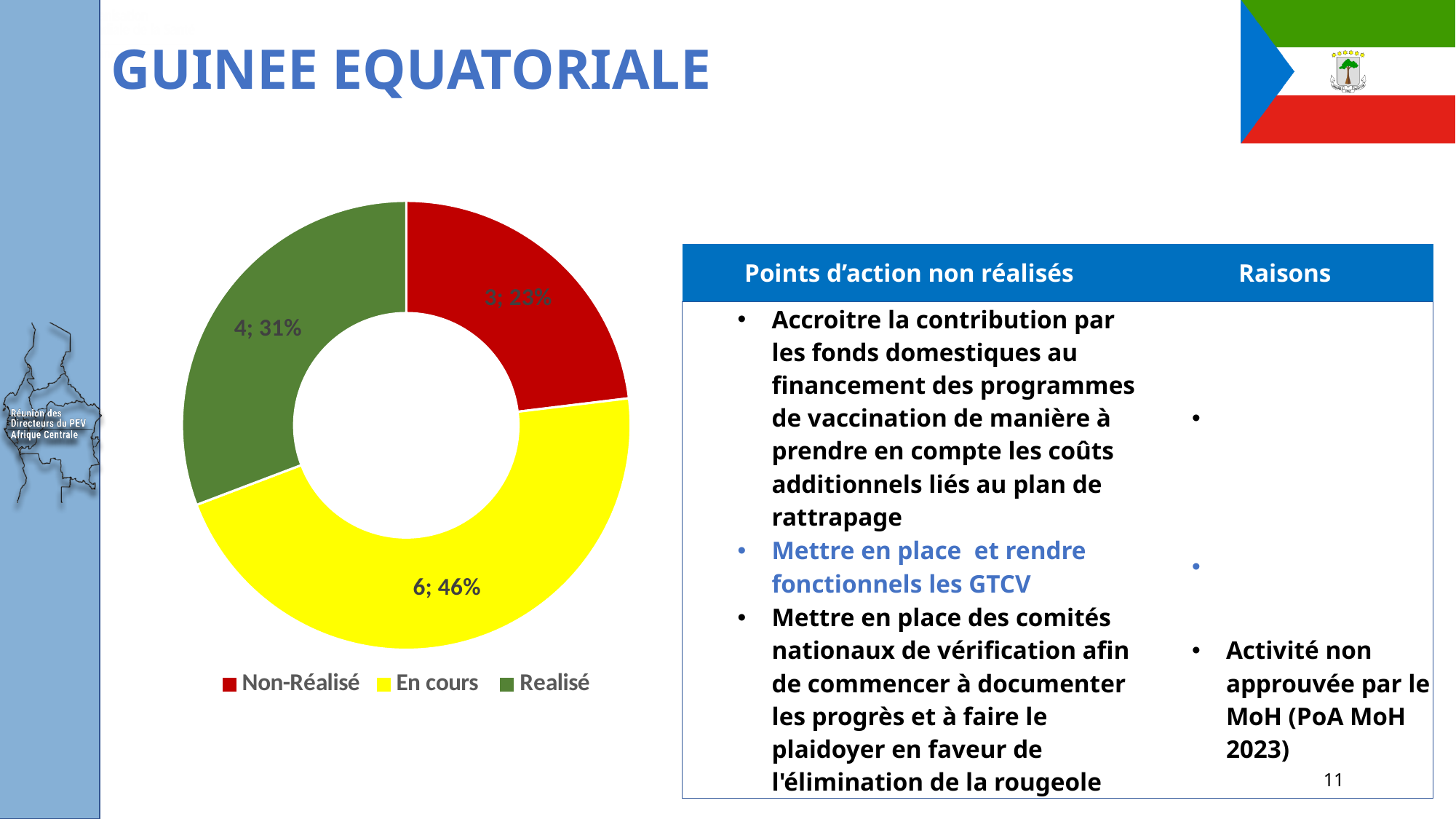
What is the count shown for the 'En cours' slice? 6 What is the difference in count between 'En cours' and 'Realisé'? 2 Which is larger, the 'Realisé' slice or the 'Non-Réalisé' slice? Realisé What percentage share does the 'Non-Réalisé' slice have? 23% How many entries does the legend of the doughnut chart list? 3 What is the count shown for the 'Non-Réalisé' slice? 3 Which category has the largest slice in the doughnut chart? En cours How many slices does the doughnut chart have? 3 What colour is used for the 'En cours' slice? Yellow What kind of chart is shown on the slide? Doughnut (pie) chart What percentage share does the 'Realisé' slice have? 31% Which category has the smallest slice in the doughnut chart? Non-Réalisé